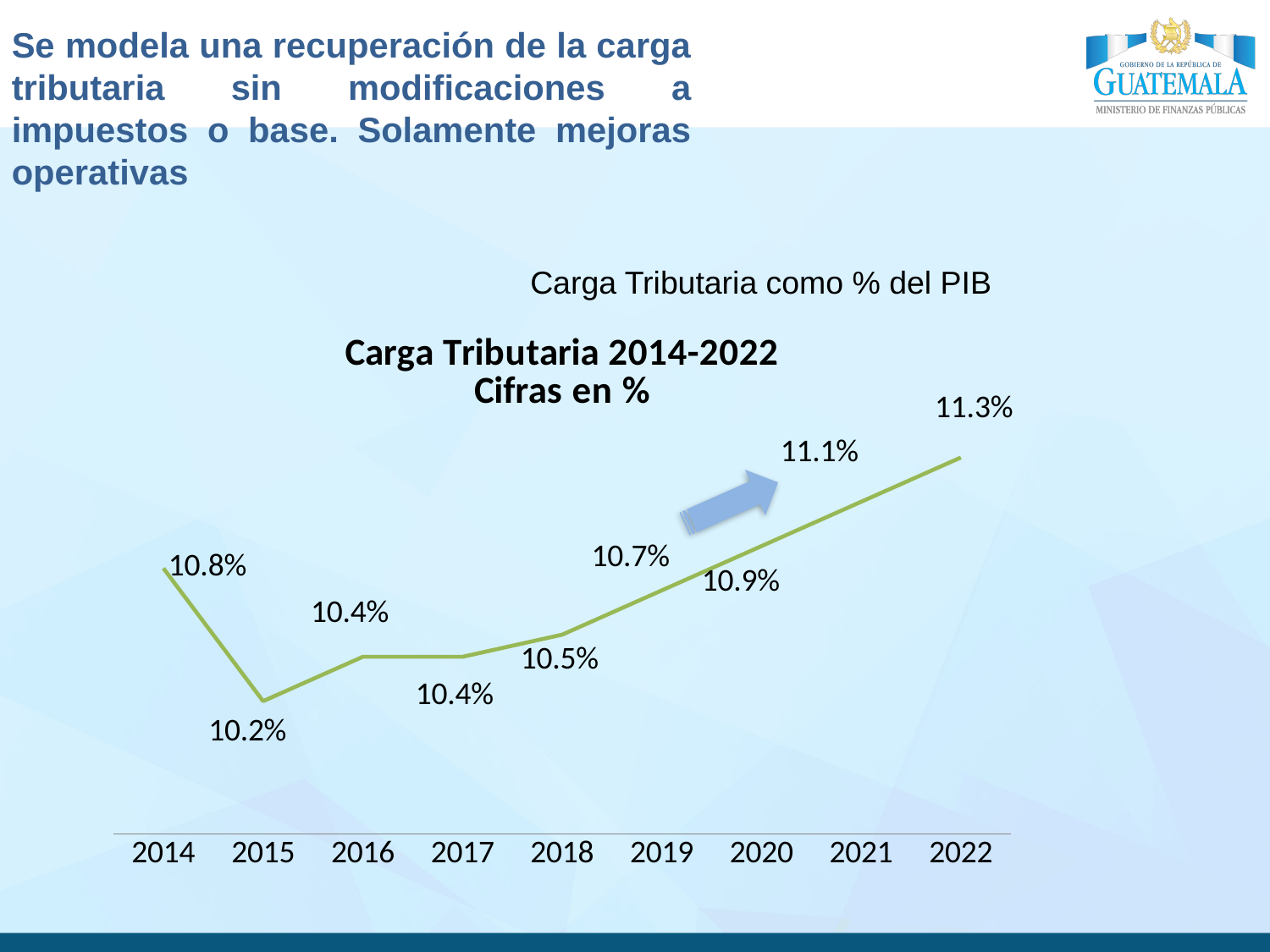
Which year has the highest value? 2022 Do the values rise or fall from 2015 to 2022? rise What is the difference between the values for 2022 and 2015? 1.1% How many years are plotted on the x axis? 9 What is the title of the chart? Carga Tributaria 2014-2022 Cifras en % What is the value for 2015? 10.2% What is the value for 2022? 11.3% Which is larger, the value for 2014 or the value for 2019? 2014 Which year has the lowest value? 2015 What type of chart is shown on the slide? line chart What is the value for 2014? 10.8% What is the value for 2018? 10.5%